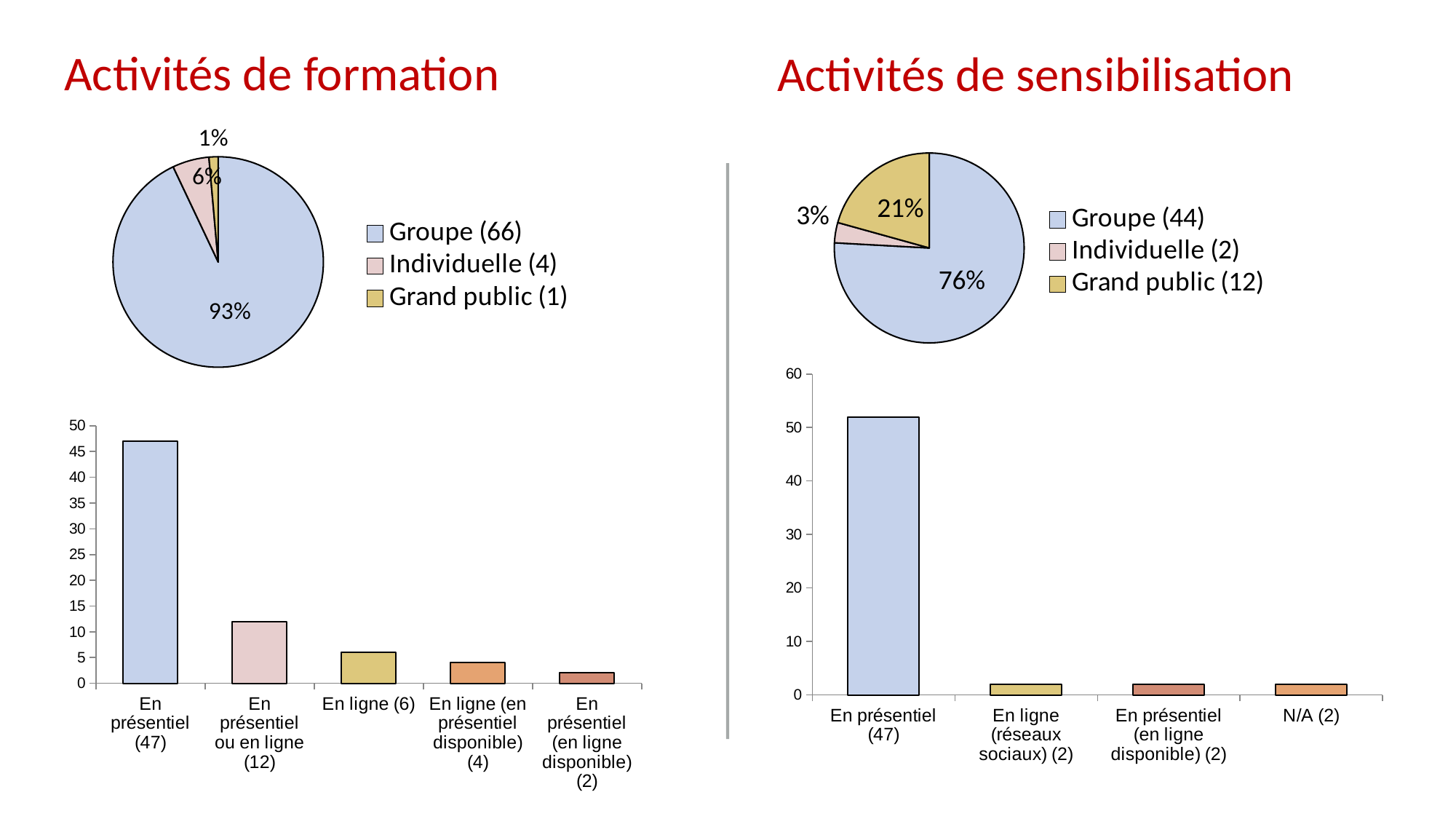
How many entries does the legend of the pie chart under 'Activités de sensibilisation' list? 3 How many categories are shown in the bar chart under 'Activités de formation'? 5 What type of chart is shown at the bottom of the 'Activités de sensibilisation' section? bar chart In the pie chart under 'Activités de sensibilisation', what count is shown for Groupe in the legend? 44 In the bar chart under 'Activités de sensibilisation', is the value for 'En présentiel' greater or less than 40? greater In the bar chart under 'Activités de formation', what is the value for 'En présentiel ou en ligne'? 12 In the pie chart under 'Activités de formation', what share does Groupe have? 93% In the pie chart under 'Activités de sensibilisation', what share does Grand public have? 21% How many categories are shown in the bar chart under 'Activités de sensibilisation'? 4 In the bar chart under 'Activités de formation', what is the difference between 'En présentiel' and 'En ligne'? 41 In the bar chart under 'Activités de formation', which category has the highest value? En présentiel In the pie chart under 'Activités de formation', which category has the smallest slice? Grand public